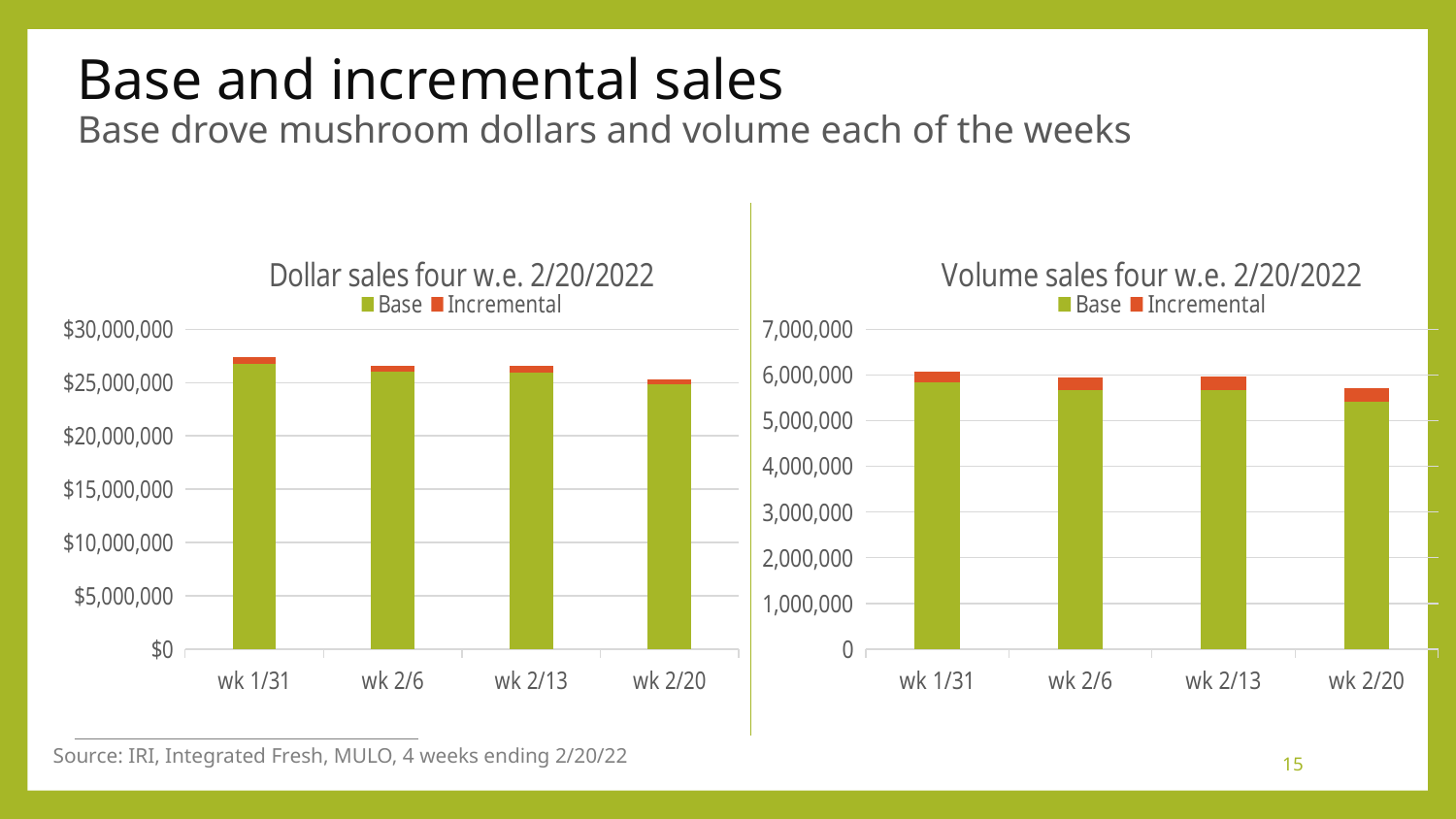
In the Volume sales four w.e. 2/20/2022 chart, which week has the lowest total bar? wk 2/20 In the Dollar sales four w.e. 2/20/2022 chart, which series is larger in every week, Base or Incremental? Base In the Dollar sales four w.e. 2/20/2022 chart, is the total for wk 1/31 greater or less than $30,000,000? less In the Dollar sales four w.e. 2/20/2022 chart, is the Base value for wk 1/31 greater or less than $25,000,000? greater How many weeks are shown on the x axis of the Dollar sales four w.e. 2/20/2022 chart? 4 In the Dollar sales four w.e. 2/20/2022 chart, which week has the lowest total bar? wk 2/20 In the Volume sales four w.e. 2/20/2022 chart, is the total for wk 2/20 greater or less than 6,000,000? less In the Dollar sales four w.e. 2/20/2022 chart, which week has the highest total bar? wk 1/31 Which colour represents the Incremental series in the Volume sales four w.e. 2/20/2022 chart? orange How many series does the legend of the Volume sales four w.e. 2/20/2022 chart list? 2 What kind of chart is the Dollar sales four w.e. 2/20/2022 chart? stacked bar chart